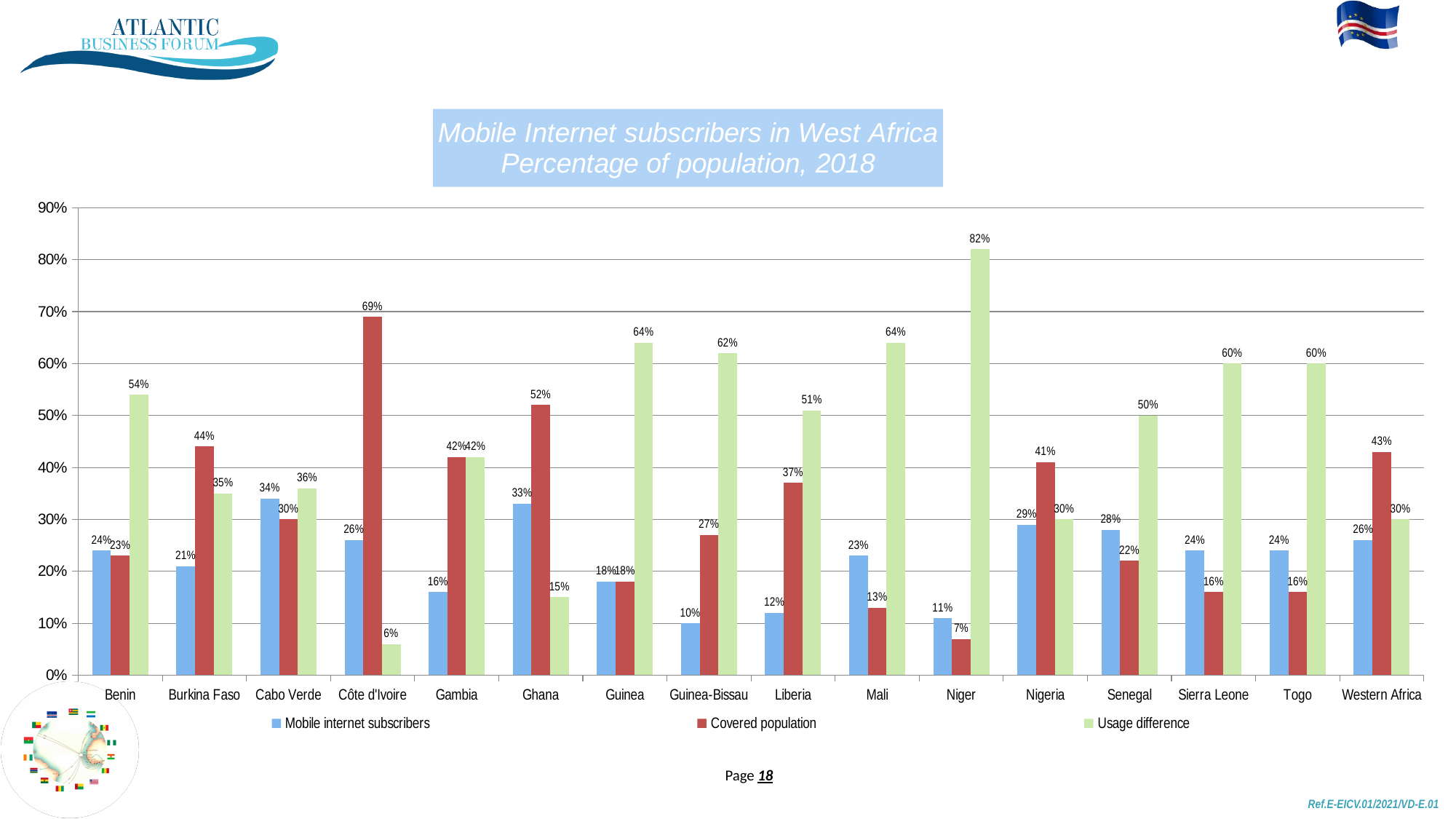
What is the Mobile internet subscribers value for Western Africa? 26% Which category has the lowest Mobile internet subscribers value? Guinea-Bissau What is the Mobile internet subscribers value for Cabo Verde? 34% Which is larger for Senegal: Mobile internet subscribers or Covered population? Mobile internet subscribers What is the difference between the Covered population and Mobile internet subscribers values for Ghana? 19% What is the Usage difference value for Niger? 82% Which country has the highest Covered population value? Côte d'Ivoire How many series does the legend list? 3 How many countries or regions are shown on the x axis? 16 What kind of chart is shown on the slide? Bar chart Which category has the lowest Usage difference value? Côte d'Ivoire What is the Covered population value for Côte d'Ivoire? 69%